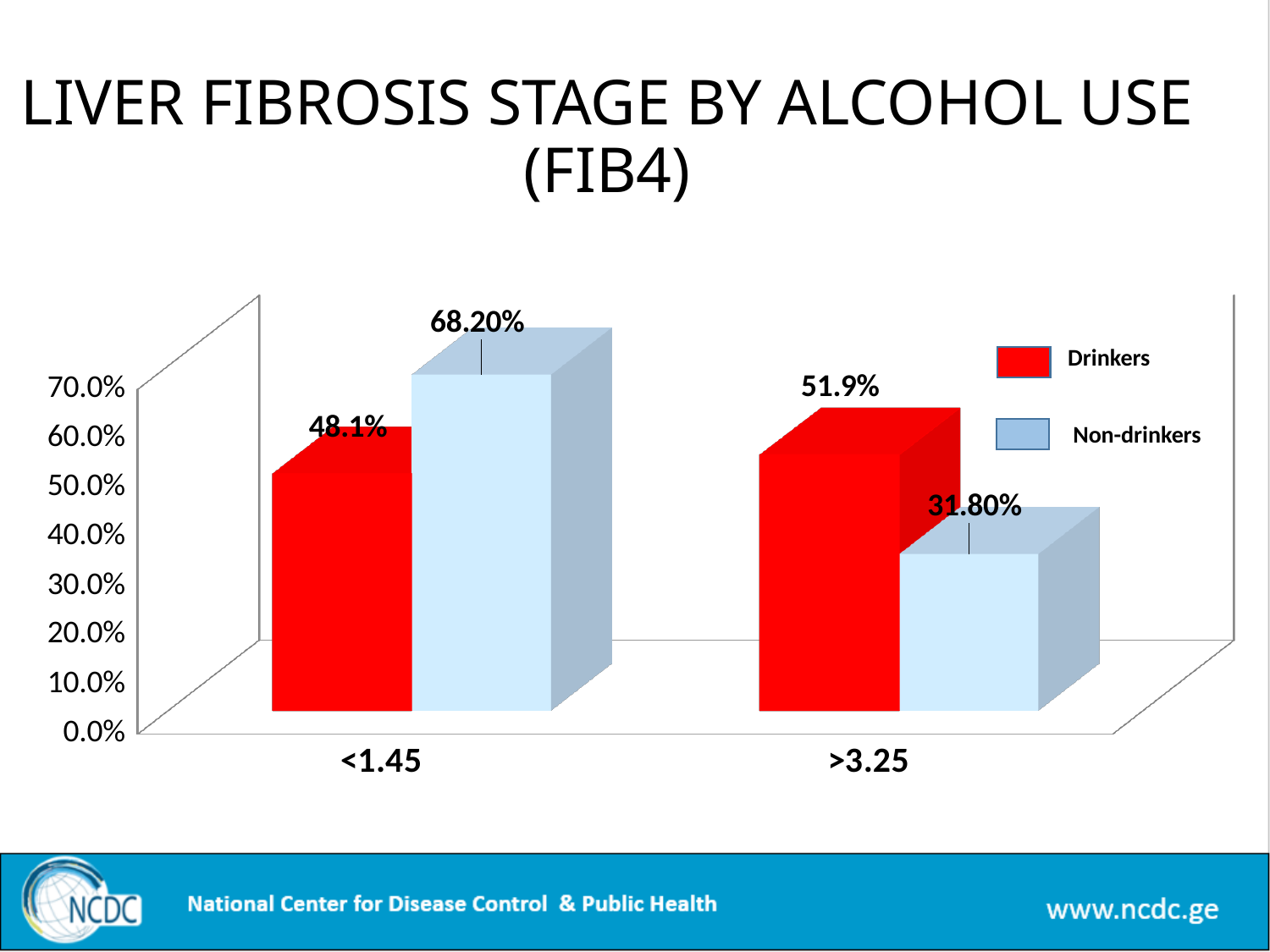
Which is larger: Drinkers in the >3.25 category or Non-drinkers in the >3.25 category? Drinkers What kind of chart is shown on the slide? Bar chart What is the difference between the Non-drinkers and Drinkers values in the <1.45 category? 20.1% Which series has the lowest value in the >3.25 category? Non-drinkers What colour represents the Drinkers series? Red What is the value for Non-drinkers in the >3.25 category? 31.80% What is the value for Non-drinkers in the <1.45 category? 68.20% What is the value for Drinkers in the >3.25 category? 51.9% How many series does the legend list? 2 How many categories are shown on the x axis? 2 What is the value for Drinkers in the <1.45 category? 48.1% Which series has the highest value in the <1.45 category? Non-drinkers